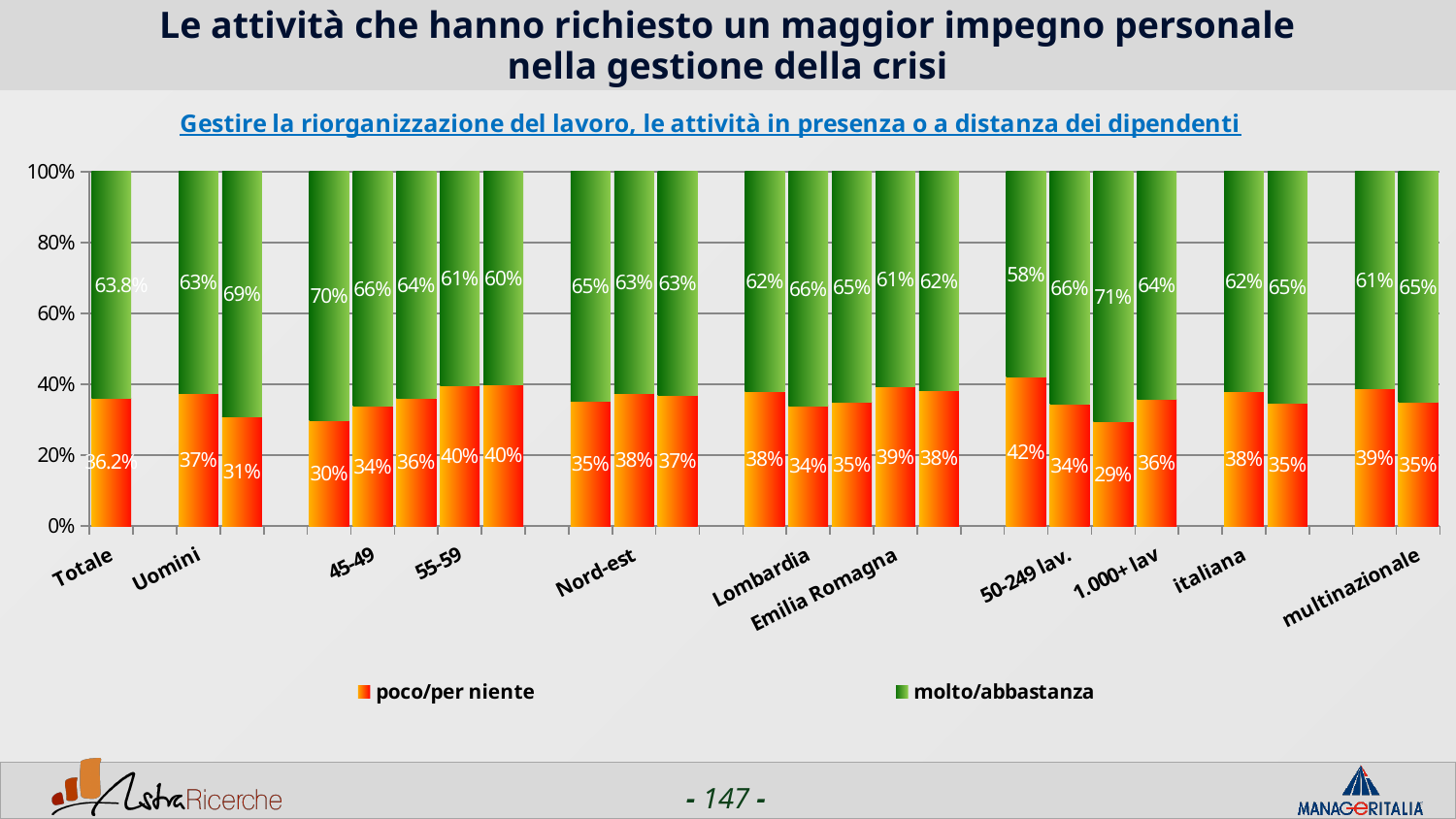
What is the value of molto/abbastanza for 1.000+ lav? 64% What is the value of molto/abbastanza for Totale? 63.8% Is the value of poco/per niente for Uomini greater or less than 40%? less How many series does the legend list? 2 What is the total of the stacked bar for Totale? 100% What kind of chart is shown on the slide? Stacked bar chart For Totale, which is larger: molto/abbastanza or poco/per niente? molto/abbastanza What are the two series named in the legend? poco/per niente and molto/abbastanza What is the value of poco/per niente for Uomini? 37% What is the value of poco/per niente for Totale? 36.2% What is the value of molto/abbastanza for Uomini? 63% What is the difference between molto/abbastanza and poco/per niente for Totale? 27.6 percentage points